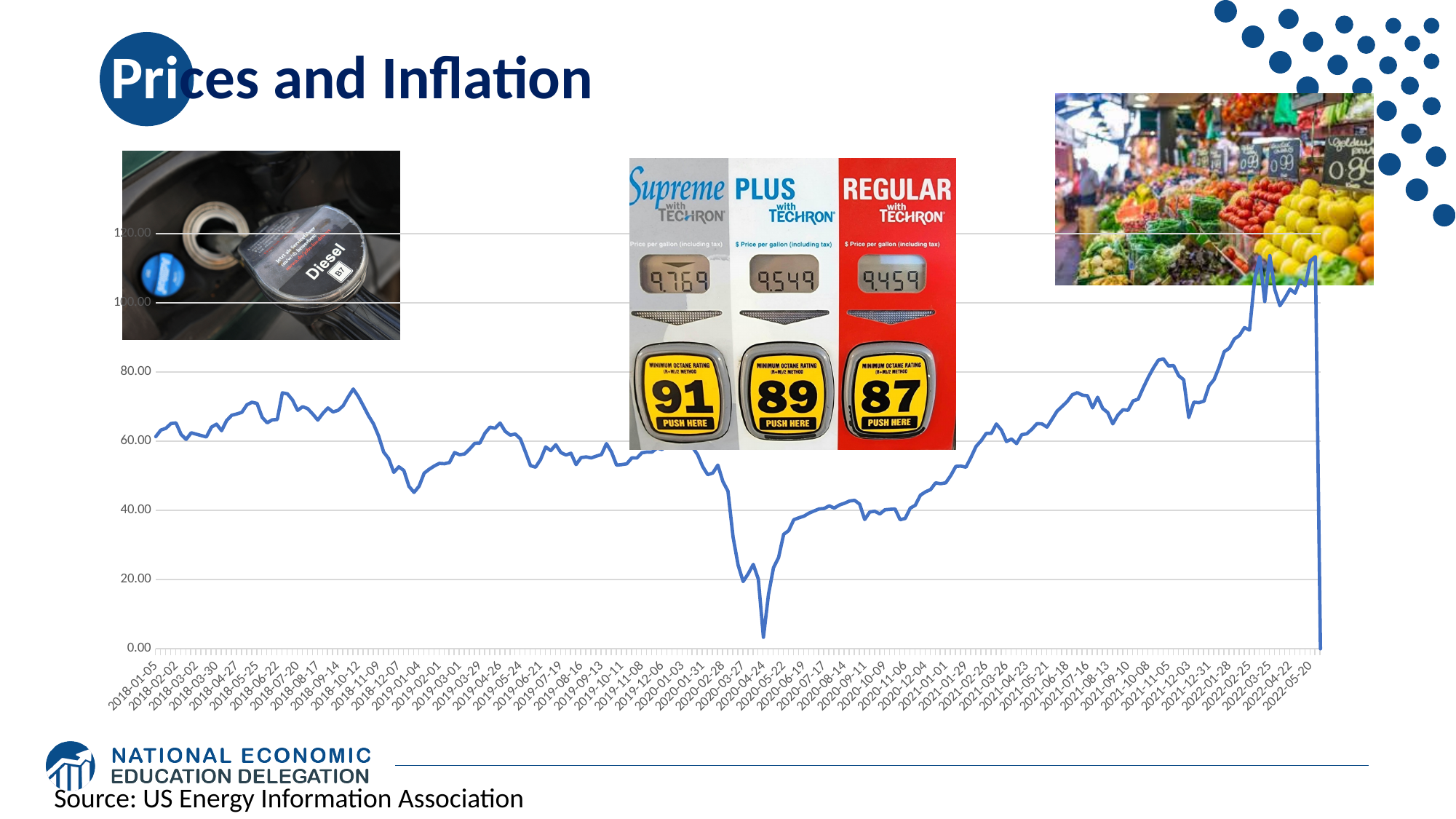
Is the value for 2022-01-28 greater or less than 80? greater What kind of chart is shown on the slide? line chart What is the highest value shown on the y axis? 120.00 Around which x-axis date in 2020 does the line dip sharply to its lowest point? 2020-04-24 Does the line rise or fall between 2018-10-12 and 2019-01-04? fall Is the value for 2022-03-25 greater or less than 100? greater Is the value for 2020-04-24 greater or less than 20? less Does the line generally rise or fall between 2020-04-24 and 2022-03-25? rise What source is cited for the chart data? US Energy Information Association